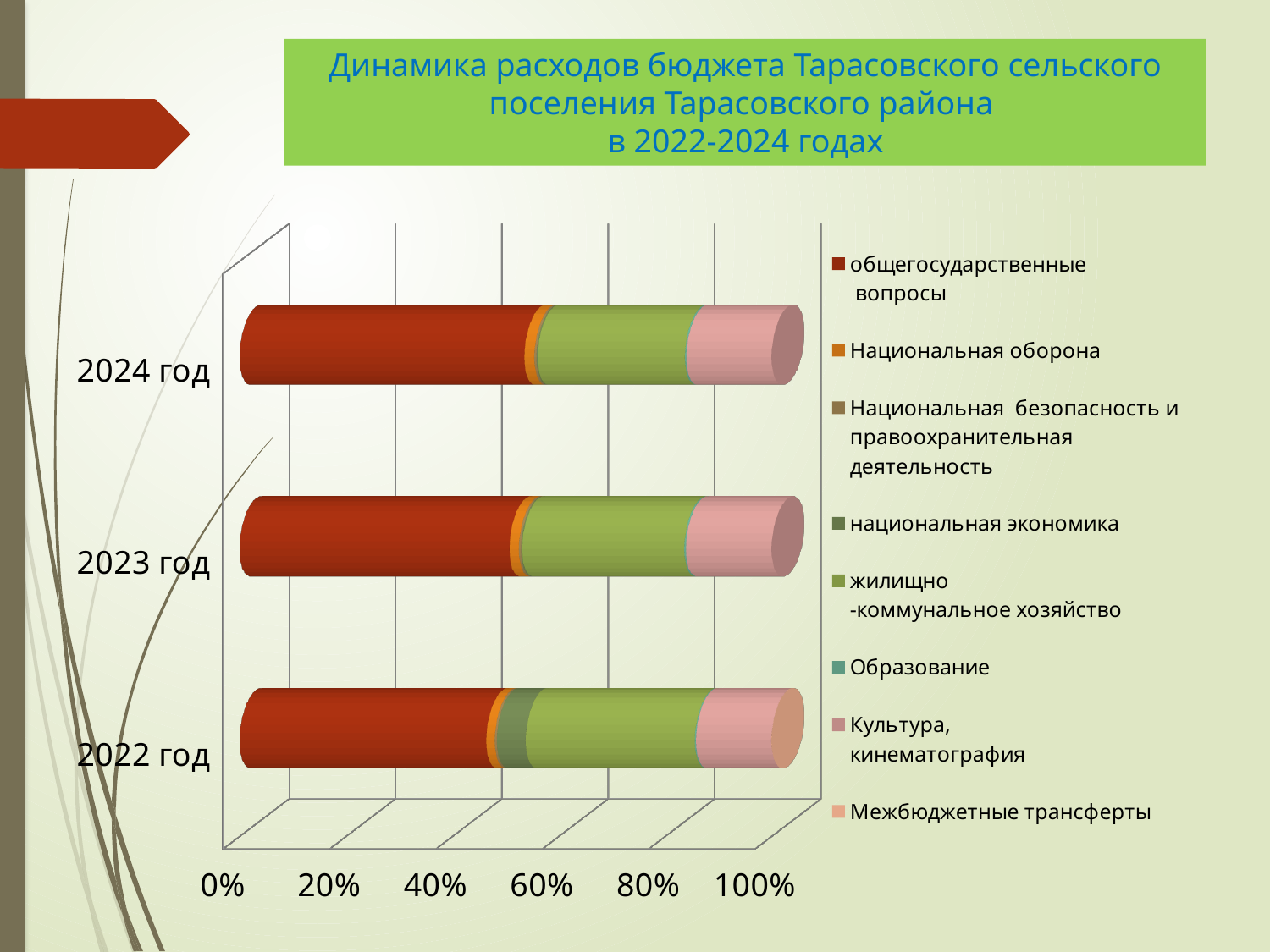
How many series does the chart legend list? 8 What is the title of the chart on the slide? Динамика расходов бюджета Тарасовского сельского поселения Тарасовского района в 2022-2024 годах Which year has the larger share for общегосударственные вопросы, 2024 год or 2022 год? 2024 год Is the share of общегосударственные вопросы in 2024 год greater or less than 60%? less How many years (categories) are plotted on the chart? 3 Is the share of общегосударственные вопросы in 2022 год greater or less than 60%? less Is the share of общегосударственные вопросы in 2024 год greater or less than 40%? greater Does the share of общегосударственные вопросы increase or decrease from 2022 год to 2024 год? increase What is the highest value shown on the horizontal axis? 100% What kind of chart is shown on the slide? stacked bar chart Which legend entry is shown in dark red? общегосударственные вопросы